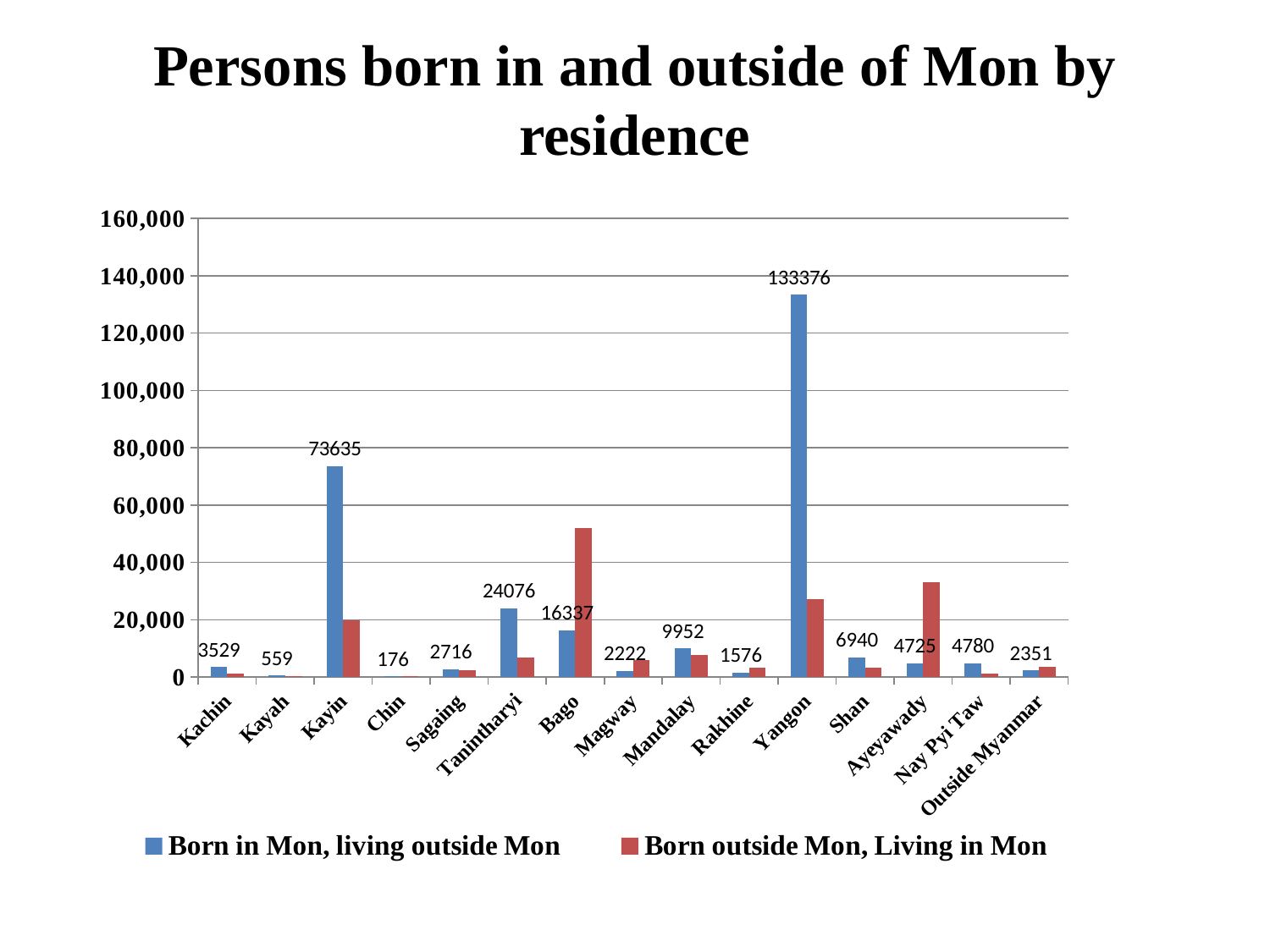
Is the 'Born outside Mon, Living in Mon' value for Bago greater or less than 40,000? greater Which category has the lowest value in the 'Born in Mon, living outside Mon' series? Chin What is the value for Yangon in the 'Born in Mon, living outside Mon' series? 133376 What is the difference between the 'Born in Mon, living outside Mon' values for Yangon and Kayin? 59741 What is the value for Kayin in the 'Born in Mon, living outside Mon' series? 73635 Is the 'Born outside Mon, Living in Mon' value for Ayeyawady greater or less than 20,000? greater What is the value for Mandalay in the 'Born in Mon, living outside Mon' series? 9952 In the 'Born in Mon, living outside Mon' series, which is larger: Tanintharyi or Bago? Tanintharyi How many categories are shown on the x axis? 15 Which category has the highest value in the 'Born in Mon, living outside Mon' series? Yangon How many series does the legend list? 2 For Bago, which series has the larger bar: 'Born in Mon, living outside Mon' or 'Born outside Mon, Living in Mon'? Born outside Mon, Living in Mon